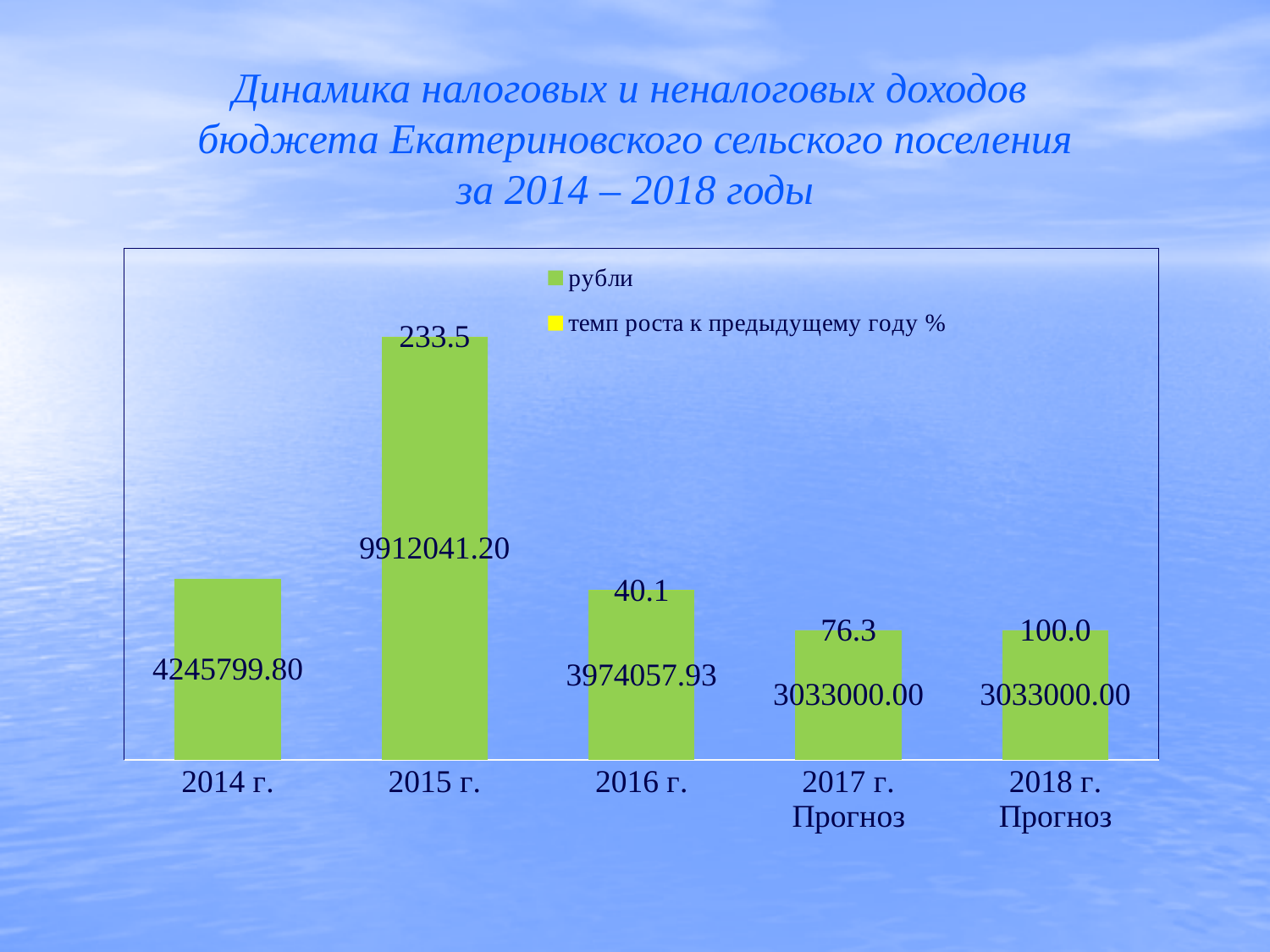
How many years (categories) are shown on the x axis? 5 Which year has the highest value in рубли? 2015 г. Do the рубли values rise or fall from 2015 г. to 2017 г. Прогноз? fall Which is larger in рубли: 2014 г. or 2016 г.? 2014 г. Which year has the lowest темп роста к предыдущему году % value shown? 2016 г. What is the value in рубли for 2014 г.? 4245799.80 What is the темп роста к предыдущему году % value shown for 2016 г.? 40.1 What is the value in рубли for 2015 г.? 9912041.20 What is the темп роста к предыдущему году % value shown for 2018 г. Прогноз? 100.0 How many series does the legend list? 2 What is the difference in рубли between 2015 г. and 2016 г.? 5937983.27 What kind of chart is shown on the slide? bar chart